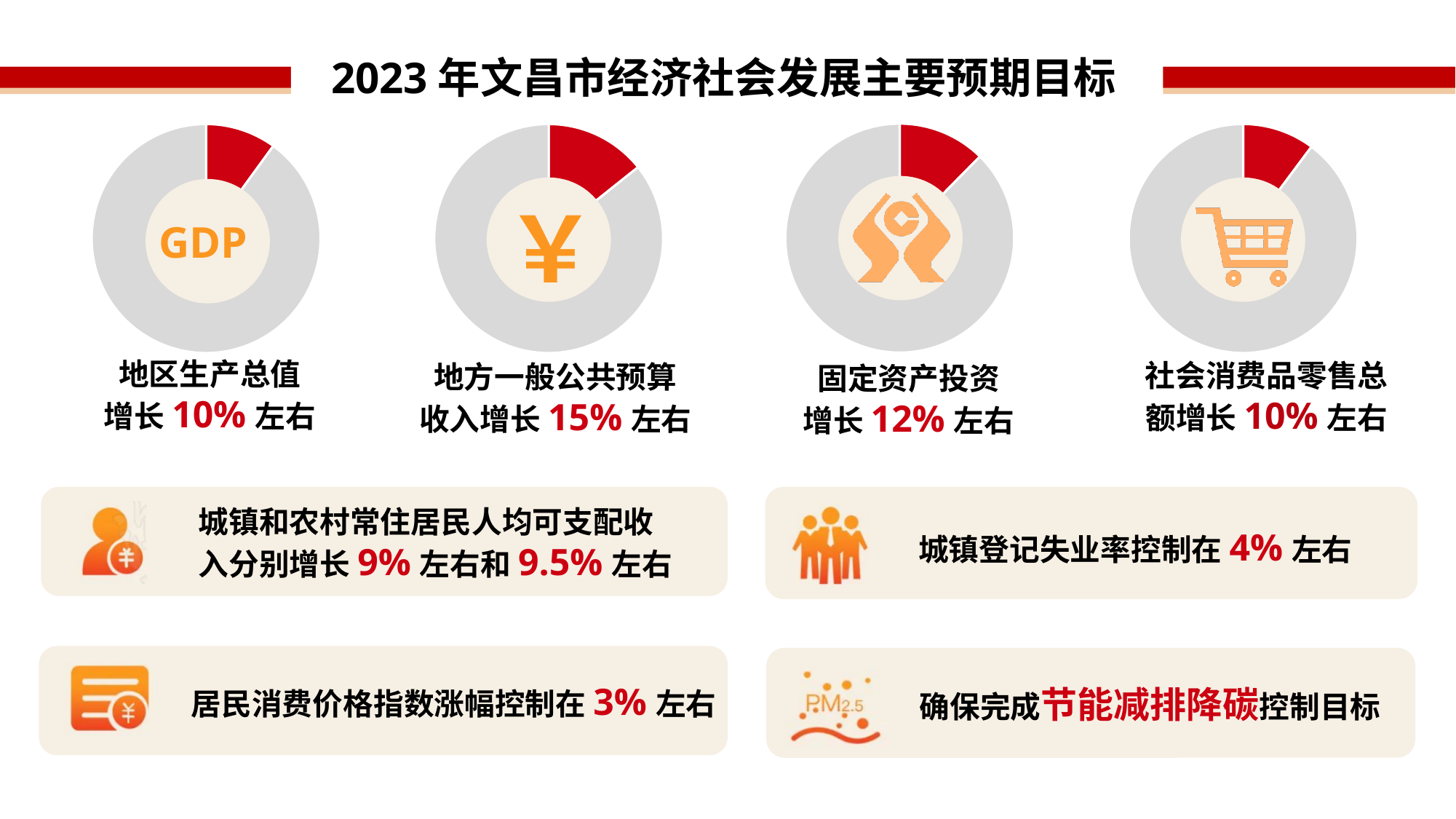
How many donut charts are shown on the slide? 4 What kind of chart is used for the four indicators at the top of the slide? Donut chart What is the target growth rate shown for 社会消费品零售总额? 10% What is the title of the slide containing the donut charts? 2023 年文昌市经济社会发展主要预期目标 What is the target growth rate shown for 地区生产总值 (GDP)? 10% What is the target growth rate shown for 固定资产投资? 12% What is the target growth rate shown for 地方一般公共预算收入? 15% What is the difference between the target growth rate for 地方一般公共预算收入 and for 地区生产总值? 5 percentage points What colour is the highlighted segment in each donut chart? Red Which is larger, the target growth rate for 固定资产投资 or for 地区生产总值? 固定资产投资 What is the difference between the target growth rate for 地方一般公共预算收入 and for 固定资产投资? 3 percentage points Which of the four donut-chart indicators has the highest target growth rate? 地方一般公共预算收入